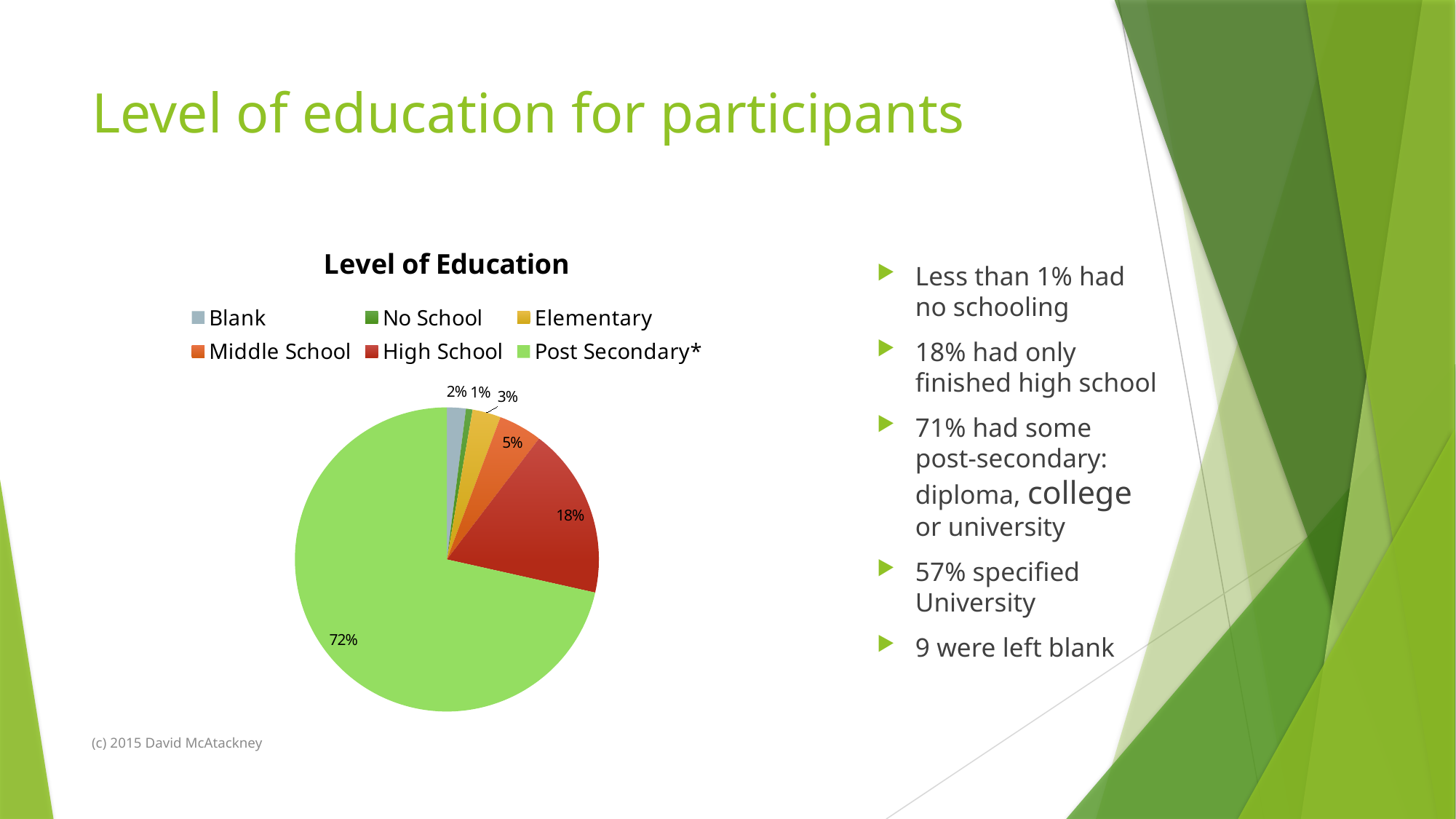
What kind of chart is shown on the slide? pie chart What percentage of the pie is Post Secondary*? 72% What percentage of the pie is Middle School? 5% How many categories does the legend of the pie chart list? 6 What is the title of the chart? Level of Education Which category has the smallest slice of the pie? No School Which slice is larger, Middle School or Elementary? Middle School What percentage of the pie is Blank? 2% What percentage of the pie is Elementary? 3% Which category has the largest slice of the pie? Post Secondary* What is the difference in percentage points between Post Secondary* and High School? 54 What percentage of the pie is High School? 18%